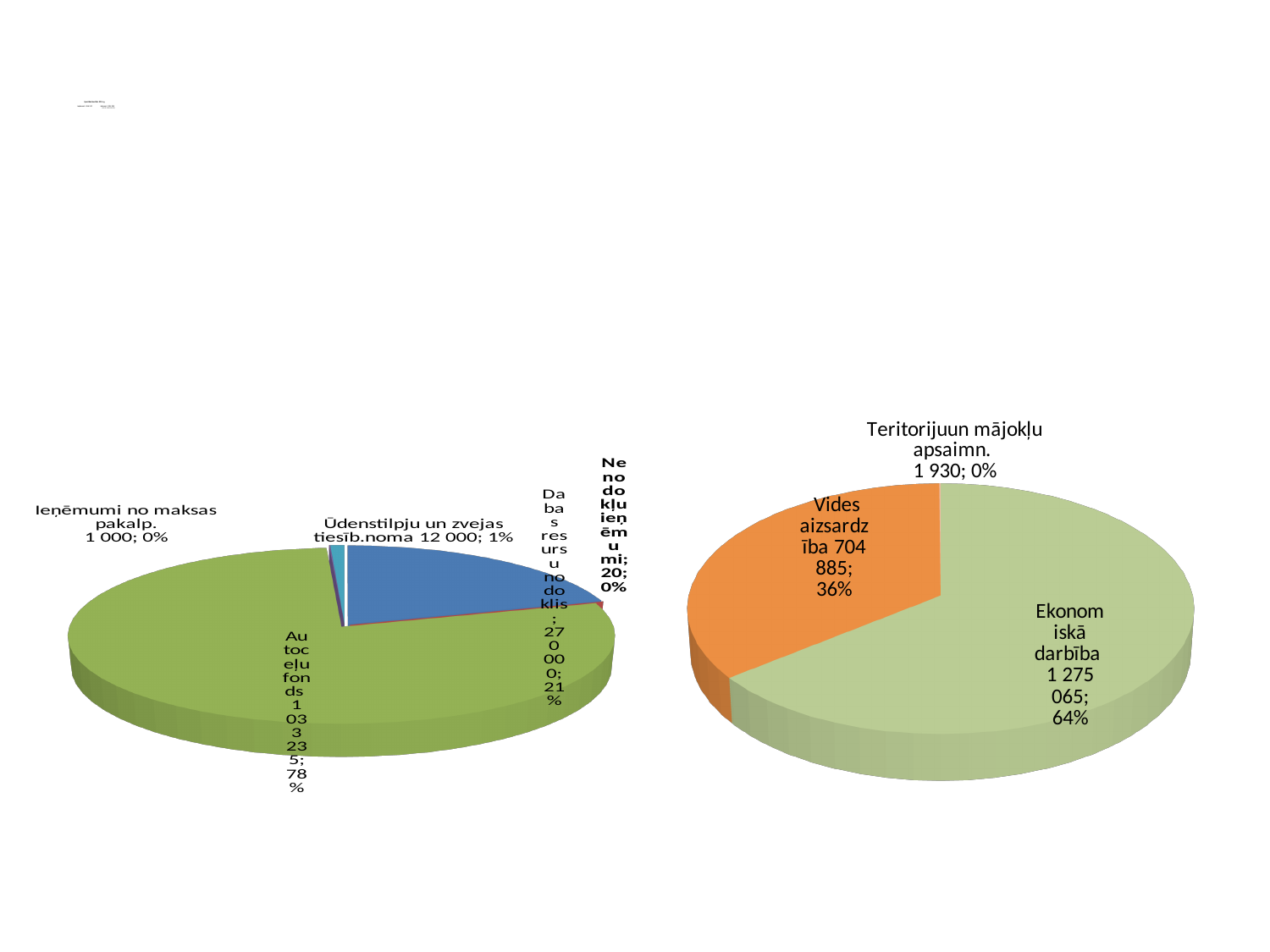
In the pie chart on the left, what value is shown for Autoceļu fonds? 1 033 235 In the pie chart on the left, what value is shown for Ūdenstilpju un zvejas tiesīb.noma? 12 000 What kind of chart is the chart on the right side of the slide? pie chart In the pie chart on the right, what value is shown for Teritoriju un mājokļu apsaimn.? 1 930 In the pie chart on the right, how many slices are labelled? 3 In the pie chart on the right, which category has the largest slice? Ekonomiskā darbība In the pie chart on the right, what share of the pie does Vides aizsardzība have? 36% In the pie chart on the right, what value is shown for Ekonomiskā darbība? 1 275 065 In the pie chart on the right, what is the difference between the values for Ekonomiskā darbība and Vides aizsardzība? 570 180 In the pie chart on the left, what share of the pie does Dabas resursu nodoklis have? 21% In the pie chart on the left, which category has the smallest value? Nenodokļu ieņēmumi In the pie chart on the left, which is larger: Ieņēmumi no maksas pakalp. or Ūdenstilpju un zvejas tiesīb.noma? Ūdenstilpju un zvejas tiesīb.noma